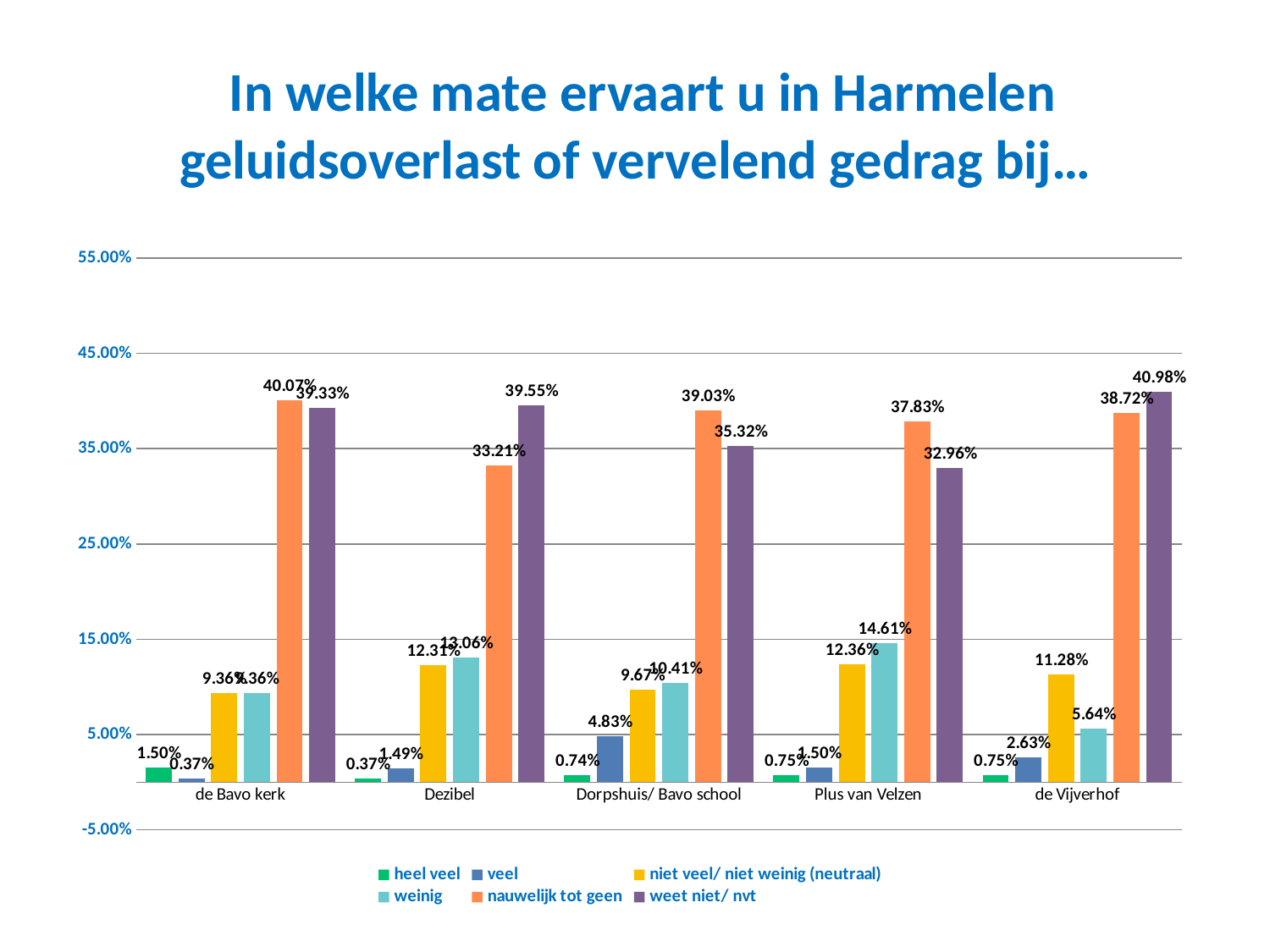
Which location has the lowest value for 'weinig'? de Vijverhof What is the value for 'nauwelijk tot geen' at Plus van Velzen? 37.83% What is the value for 'weet niet/ nvt' at de Vijverhof? 40.98% At Dezibel, which is larger: 'nauwelijk tot geen' or 'weet niet/ nvt'? weet niet/ nvt What is the value for 'niet veel/ niet weinig (neutraal)' at de Vijverhof? 11.28% What kind of chart is shown on the slide? bar chart Is the value for 'nauwelijk tot geen' at de Bavo kerk greater or less than 35.00%? greater How many locations (categories) are shown on the x axis? 5 Which location has the highest value for 'weet niet/ nvt'? de Vijverhof How many series does the legend list? 6 What is the difference between the 'weinig' values for Plus van Velzen and de Vijverhof? 8.97% What is the value for 'veel' at Dorpshuis/ Bavo school? 4.83%